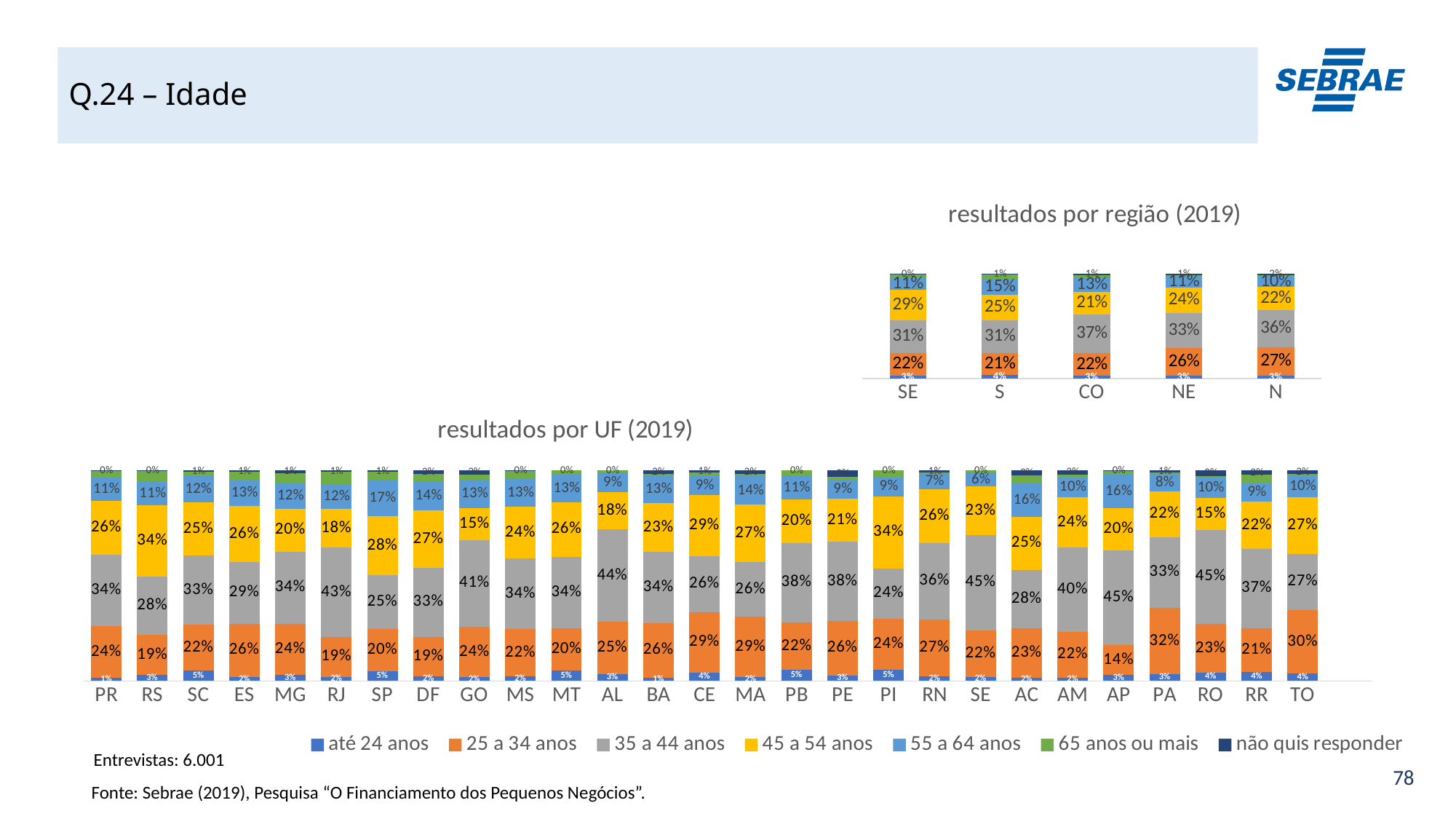
In the 'resultados por região (2019)' chart, which region has the highest value for '45 a 54 anos'? SE How many series does the legend list? 7 In the 'resultados por UF (2019)' chart, what is the value of '25 a 34 anos' for PA? 32% In the 'resultados por UF (2019)' chart, what is the difference between the '35 a 44 anos' values for RJ and SP? 18 percentage points In the 'resultados por UF (2019)' chart, which has the larger '45 a 54 anos' value, RS or GO? RS In the 'resultados por UF (2019)' chart, which UF has the highest value for '25 a 34 anos'? PA In the 'resultados por região (2019)' chart, what is the value of '55 a 64 anos' for S? 15% In the 'resultados por UF (2019)' chart, how many UFs are shown on the x axis? 27 What kind of chart is the 'resultados por UF (2019)' chart? Stacked bar chart In the 'resultados por região (2019)' chart, how many regions are shown? 5 In the 'resultados por região (2019)' chart, what is the value of '35 a 44 anos' for CO? 37% In the 'resultados por UF (2019)' chart, which UF has the lowest value for '25 a 34 anos'? AP